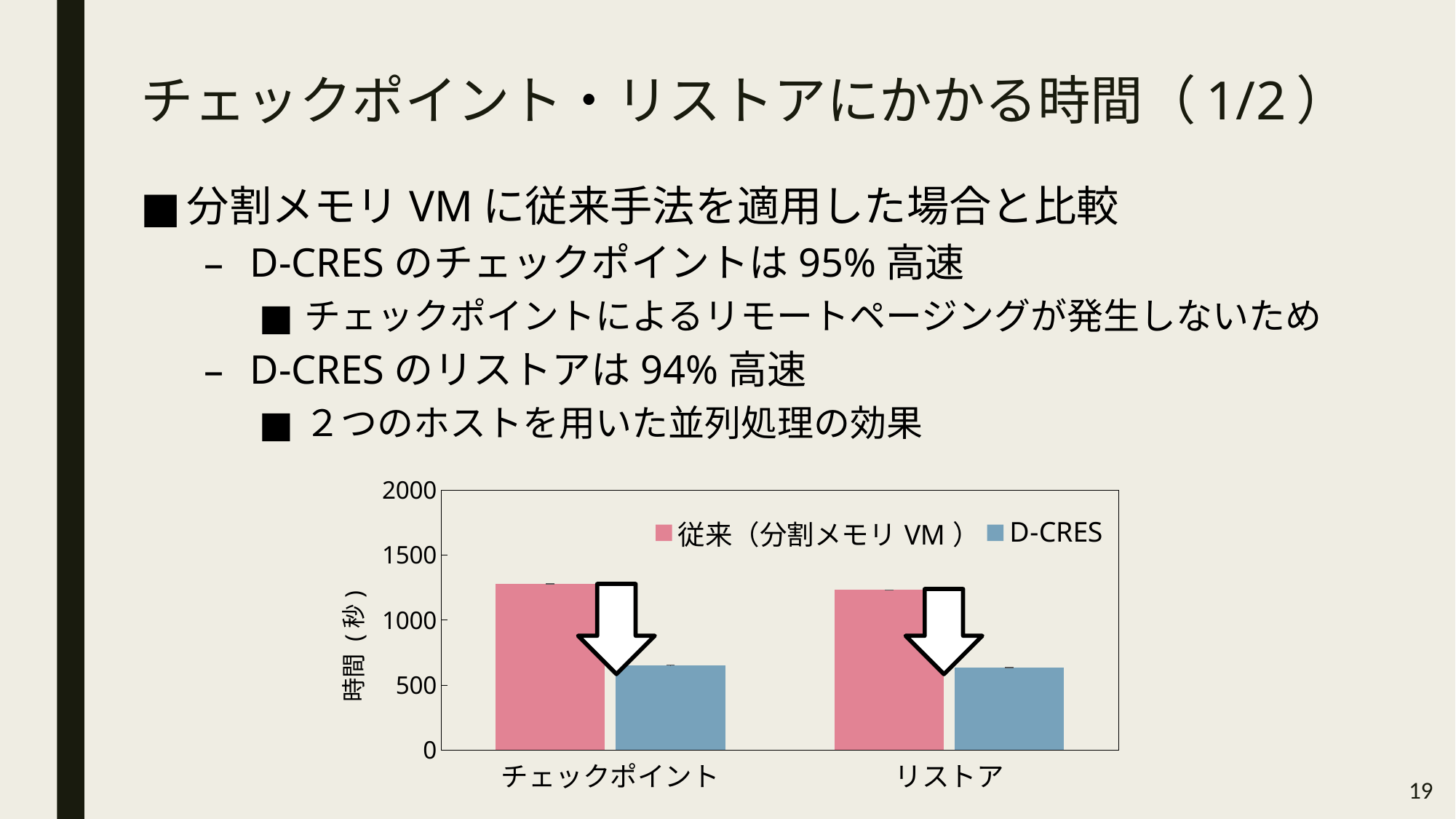
How many categories are shown on the x axis of the chart? 2 What is the highest value shown on the y axis of the chart? 2000 Is the value for 従来（分割メモリ VM）in the チェックポイント category greater or less than 1000? greater In the リストア category, which series has the smaller value, 従来（分割メモリ VM）or D-CRES? D-CRES What are the two series named in the chart legend? 従来（分割メモリ VM）and D-CRES Is the value for D-CRES in the チェックポイント category greater or less than 1000? less Is the value for D-CRES in the リストア category greater or less than 500? greater How many series does the chart legend list? 2 What is the label of the y axis of the chart? 時間（秒） In the チェックポイント category, which series has the larger value, 従来（分割メモリ VM）or D-CRES? 従来（分割メモリ VM） What kind of chart is shown on the slide? bar chart